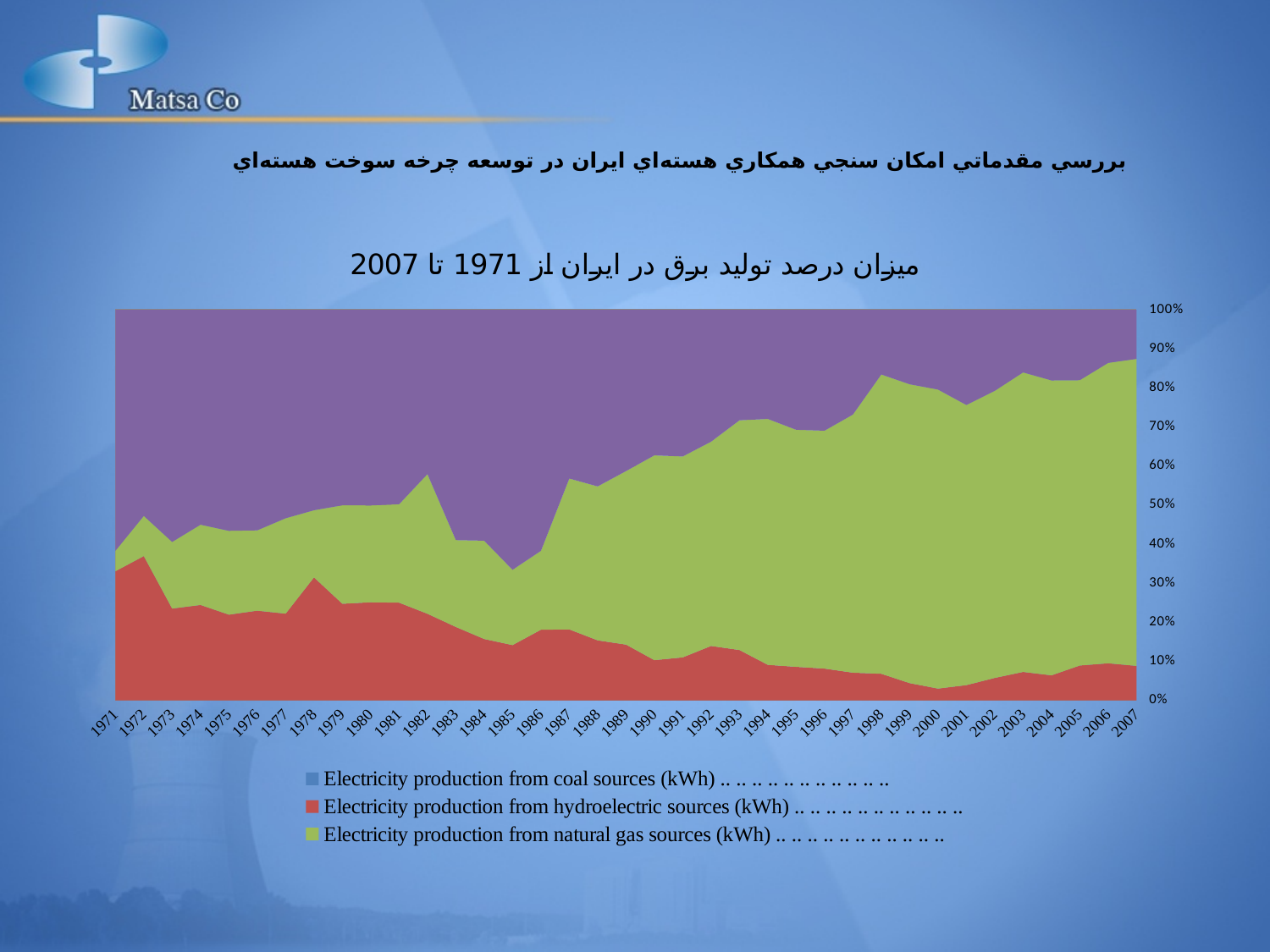
Is the share of electricity production from hydroelectric sources in 1971 greater or less than 30%? greater What is the last year shown on the x axis? 2007 How many series does the legend list? 3 What is the first year shown on the x axis? 1971 Does the share of electricity production from hydroelectric sources rise or fall from 1971 to 2007? Fall Is the share of electricity production from hydroelectric sources in 2007 greater or less than 20%? less How many years are plotted along the x axis? 37 Is the combined share of hydroelectric and natural gas sources in 2007 greater or less than 80%? greater Which year has the highest share of electricity production from hydroelectric sources? 1972 What kind of chart is shown on the slide? Stacked area chart Does the share of electricity production from natural gas sources rise or fall from 1971 to 2007? Rise